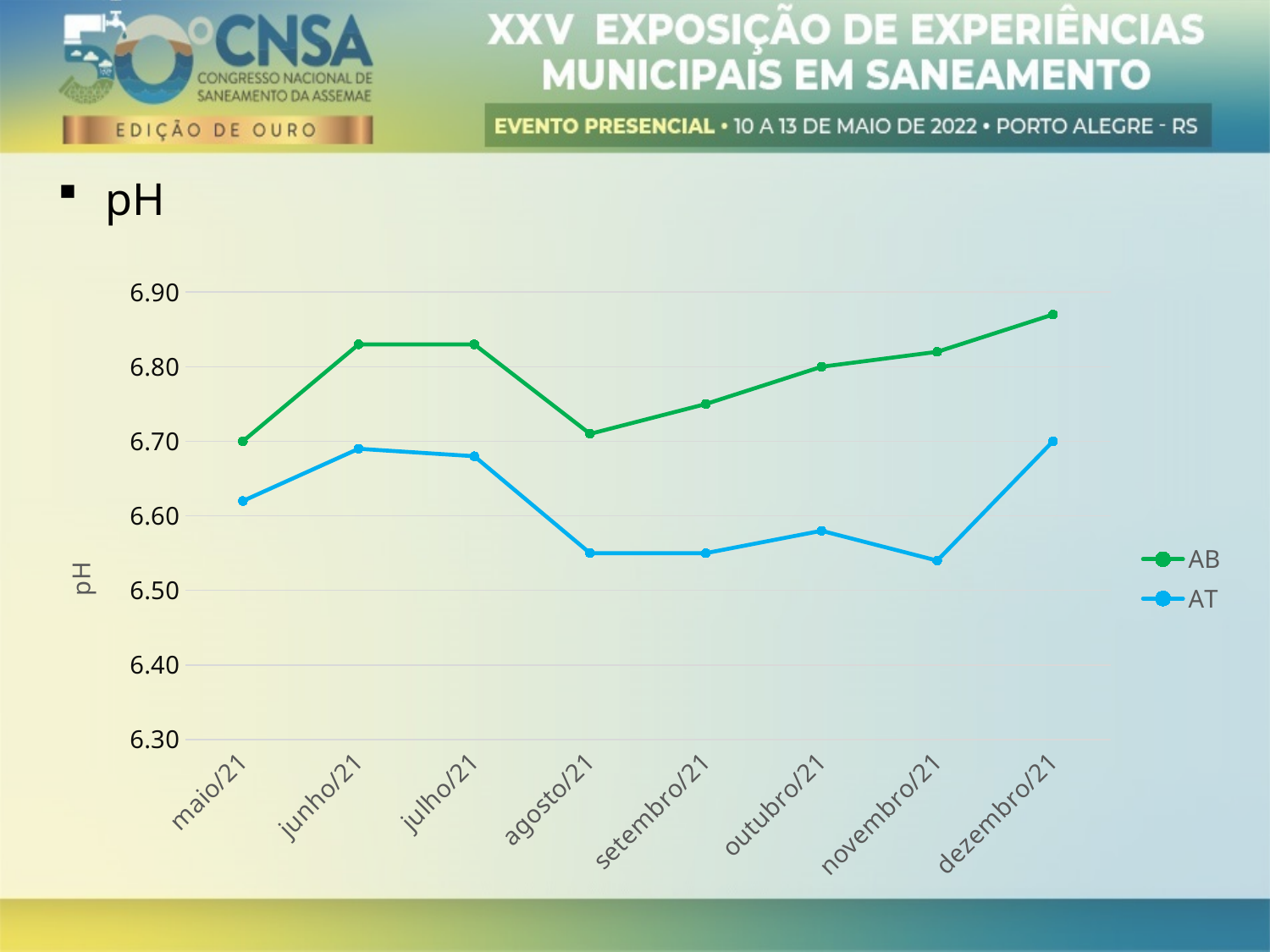
In which month does the AB series reach its highest pH value? dezembro/21 What kind of chart is shown on the slide? line chart How many series does the legend list? 2 Does the AT series rise or fall from julho/21 to agosto/21? fall Does the AB series rise or fall from agosto/21 to dezembro/21? rise How many months are plotted along the x axis? 8 Is the pH value for AB in dezembro/21 greater or less than 6.80? greater Is the pH value for AT in novembro/21 greater or less than 6.60? less Is the pH value for AB in setembro/21 greater or less than 6.70? greater What are the two series names shown in the legend? AB and AT Which series has the higher pH value in agosto/21, AB or AT? AB